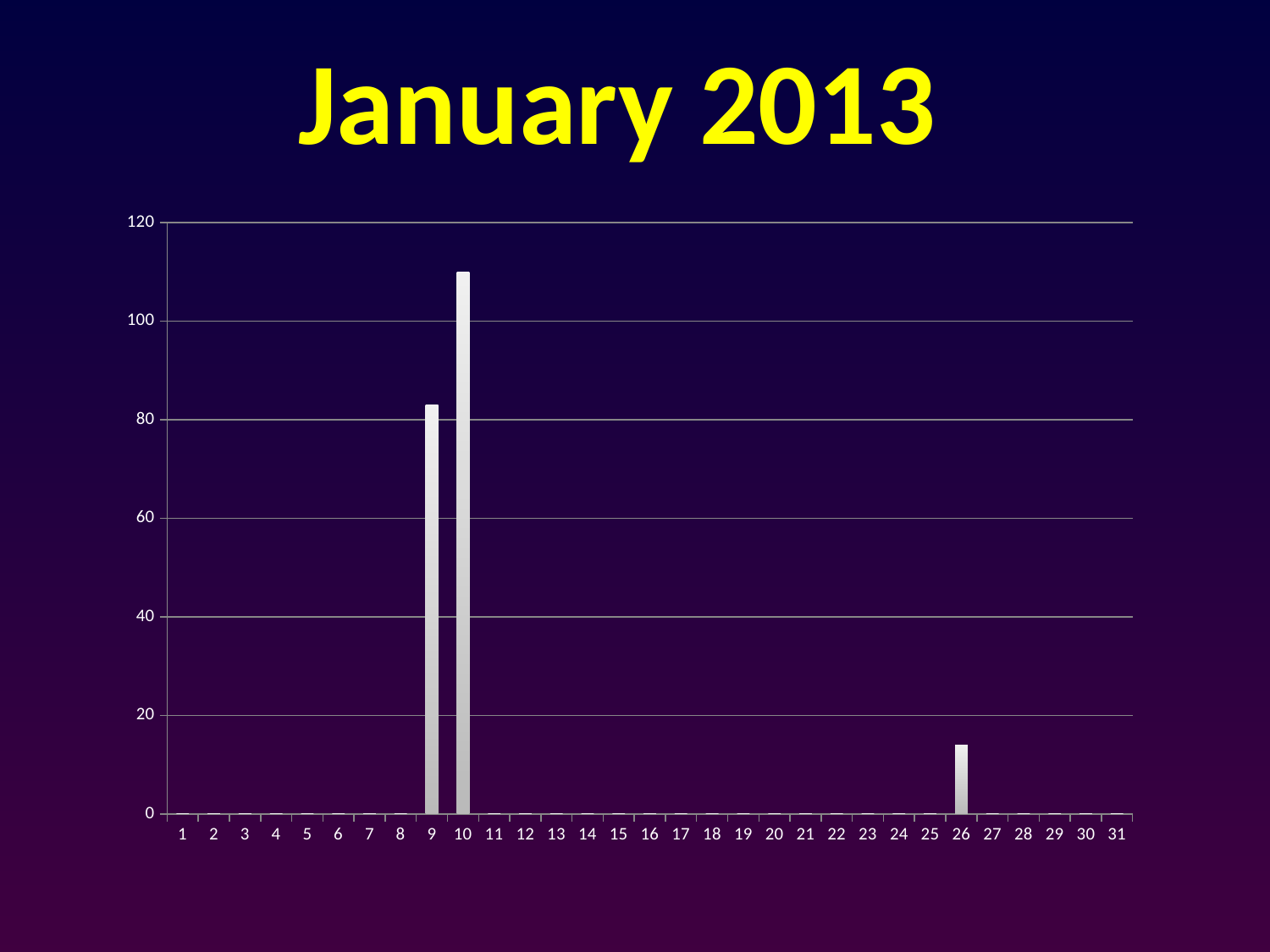
What is the highest value shown on the y axis? 120 Is the value for category 9 greater or less than 100? less Is the value for category 9 greater or less than 80? greater What kind of chart is shown on the slide? bar chart Is the value for category 10 greater or less than 100? greater Which category on the x axis has the highest bar? 10 How many categories are shown along the x axis? 31 Which is larger, the value for category 26 or the value for category 9? 9 What is the title of the slide? January 2013 Which is larger, the value for category 9 or the value for category 10? 10